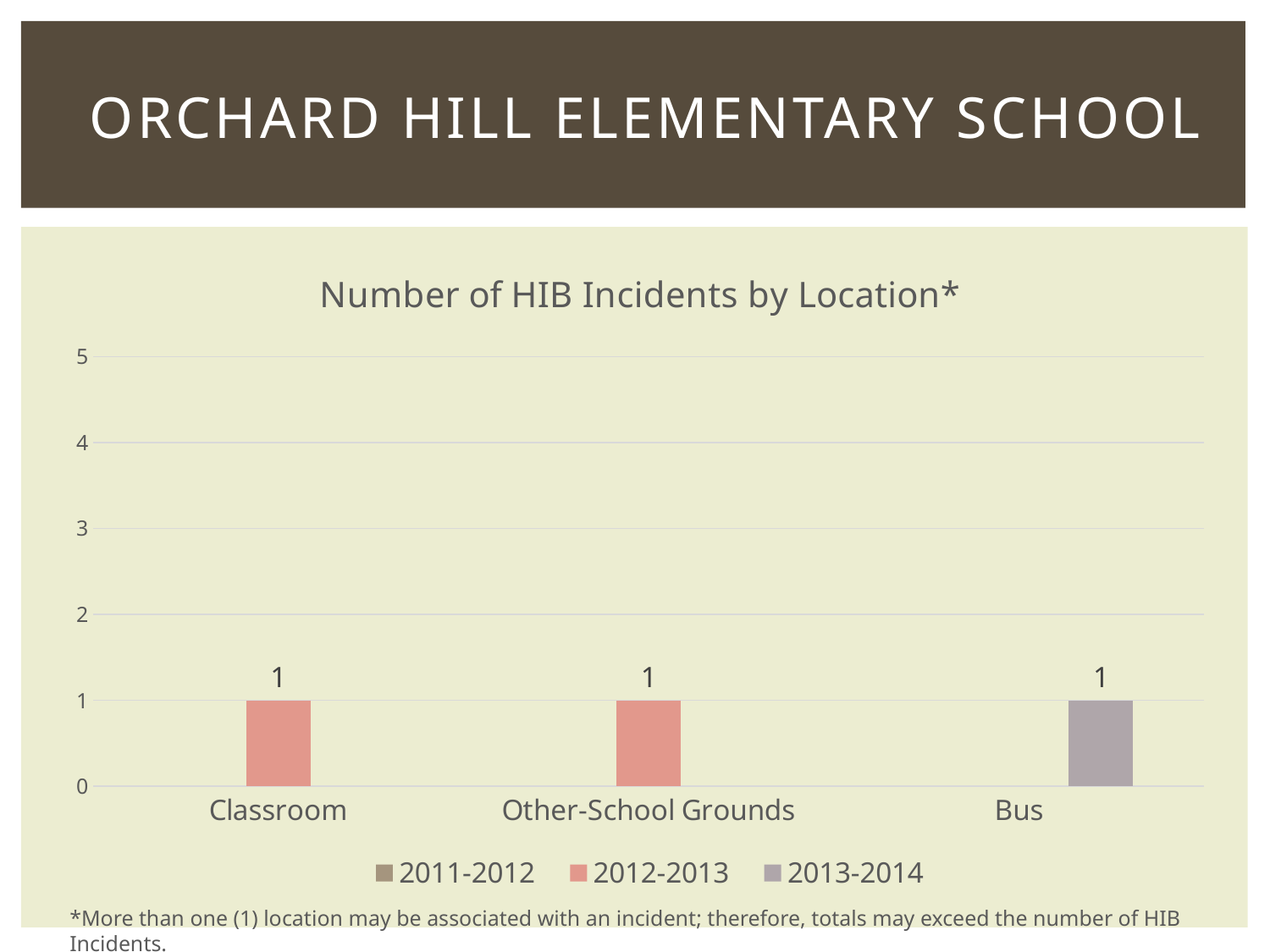
What kind of chart is shown on the slide? bar chart Which series has no bars plotted for any location? 2011-2012 Is the value for Bus in 2013-2014 greater or less than 2? less Is the value for Classroom in 2012-2013 greater or less than 3? less How many location categories are shown on the x axis? 3 What is the value for Other-School Grounds in the 2012-2013 series? 1 What is the value for Bus in the 2013-2014 series? 1 What is the highest value shown on the vertical axis? 5 How many series does the legend list? 3 Which series has a bar plotted for the Bus category? 2013-2014 What is the value for Classroom in the 2012-2013 series? 1 What is the title of the chart? Number of HIB Incidents by Location*